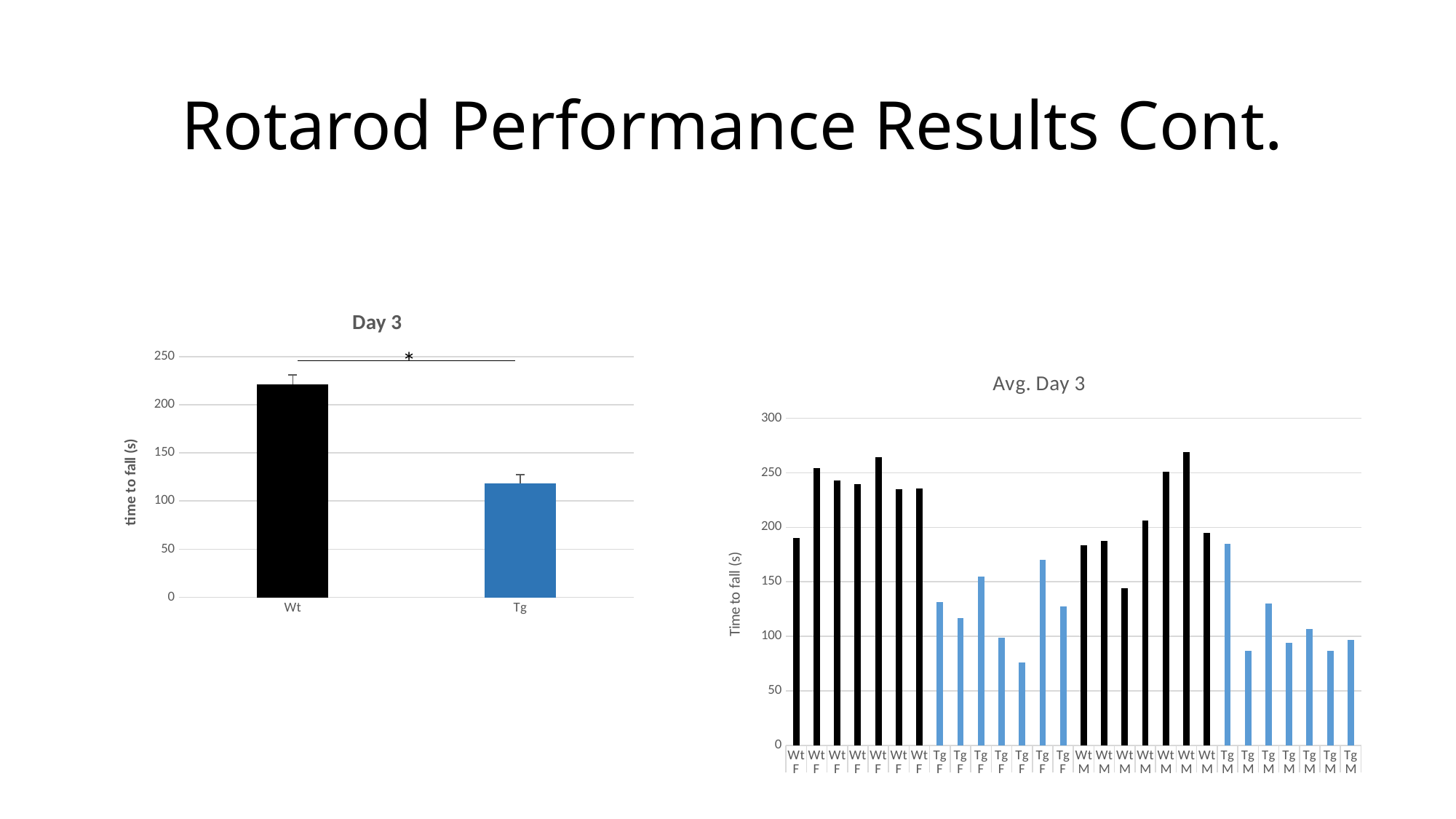
What kind of chart is the Day 3 chart on the left? bar chart In the Day 3 chart on the left, how many categories are shown on the x axis? 2 In the Day 3 chart on the left, which bar is taller, Wt or Tg? Wt In the Avg. Day 3 chart on the right, what colour are the Tg bars? blue In the Day 3 chart on the left, is the value for Tg greater or less than 100? greater In the Day 3 chart on the left, is the value for Wt greater or less than 200? greater In the Avg. Day 3 chart on the right, is the value of the first Wt F bar greater or less than 200? less What kind of chart is the Avg. Day 3 chart on the right? bar chart In the Avg. Day 3 chart on the right, which group does the lowest bar belong to? Tg F What is the y-axis label of the Day 3 chart on the left? time to fall (s) In the Avg. Day 3 chart on the right, how many bars are plotted? 28